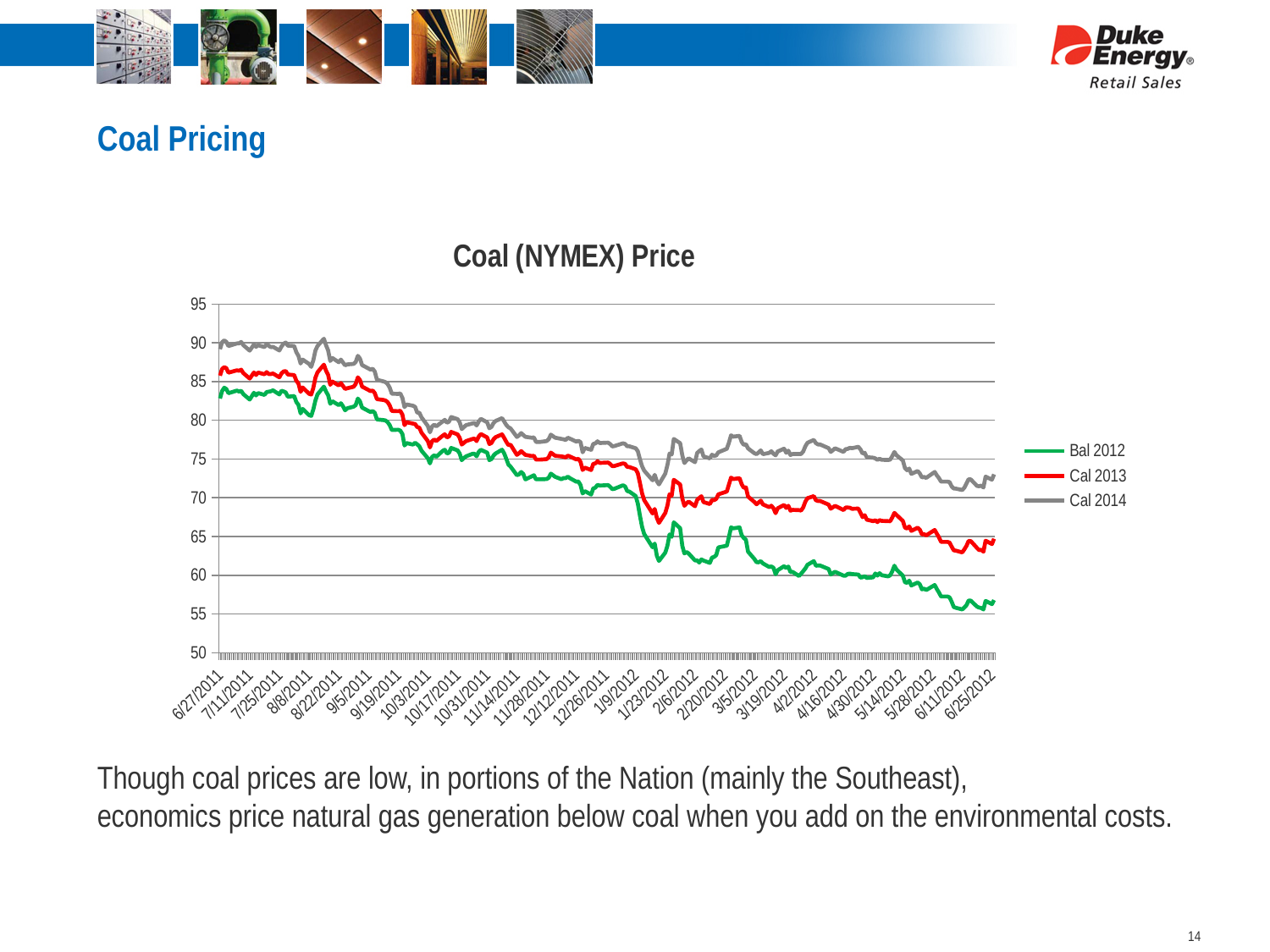
Is the value for Cal 2014 at 6/25/2012 greater or less than 70? greater Is the value for Bal 2012 at 6/25/2012 greater or less than 60? less Do the Cal 2014 values rise or fall over the period shown? fall How many series does the legend of the Coal (NYMEX) Price chart list? 3 At 6/25/2012, which is larger: the Cal 2014 value or the Bal 2012 value? Cal 2014 Which series in the Coal (NYMEX) Price chart is drawn in green? Bal 2012 Which series has the lowest values throughout the Coal (NYMEX) Price chart? Bal 2012 What kind of chart is shown on the slide? line chart What is the title of the chart on the slide? Coal (NYMEX) Price Do the Bal 2012 values rise or fall from 6/27/2011 to 6/25/2012? fall Which series has the highest values throughout the Coal (NYMEX) Price chart? Cal 2014 Is the value for Bal 2012 at 6/27/2011 greater or less than 80? greater